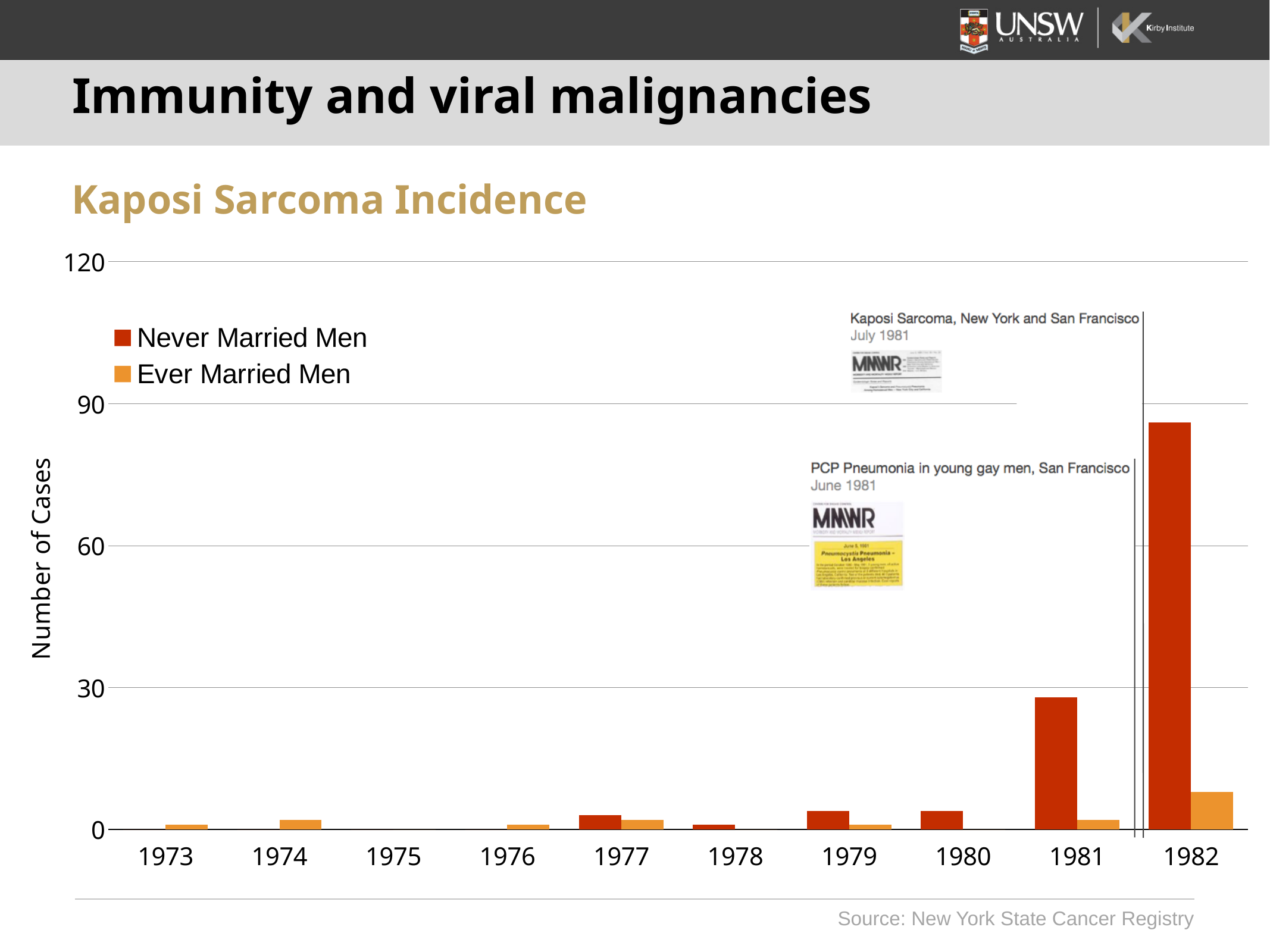
How many series does the legend list? 2 In 1982, which series has the larger value, Never Married Men or Ever Married Men? Never Married Men Is the value for Ever Married Men in 1982 greater or less than 30? less In which year is the value for Never Married Men highest? 1982 What is the label on the y axis? Number of Cases What kind of chart is shown on the slide? bar chart Is the value for Never Married Men in 1981 greater or less than 30? less In which year is the value for Ever Married Men highest? 1982 Which is larger, the value for Never Married Men in 1981 or in 1982? 1982 Is the value for Never Married Men in 1982 greater or less than 60? greater How many years are shown along the x axis? 10 Do the values for Never Married Men generally rise or fall from 1973 to 1982? rise